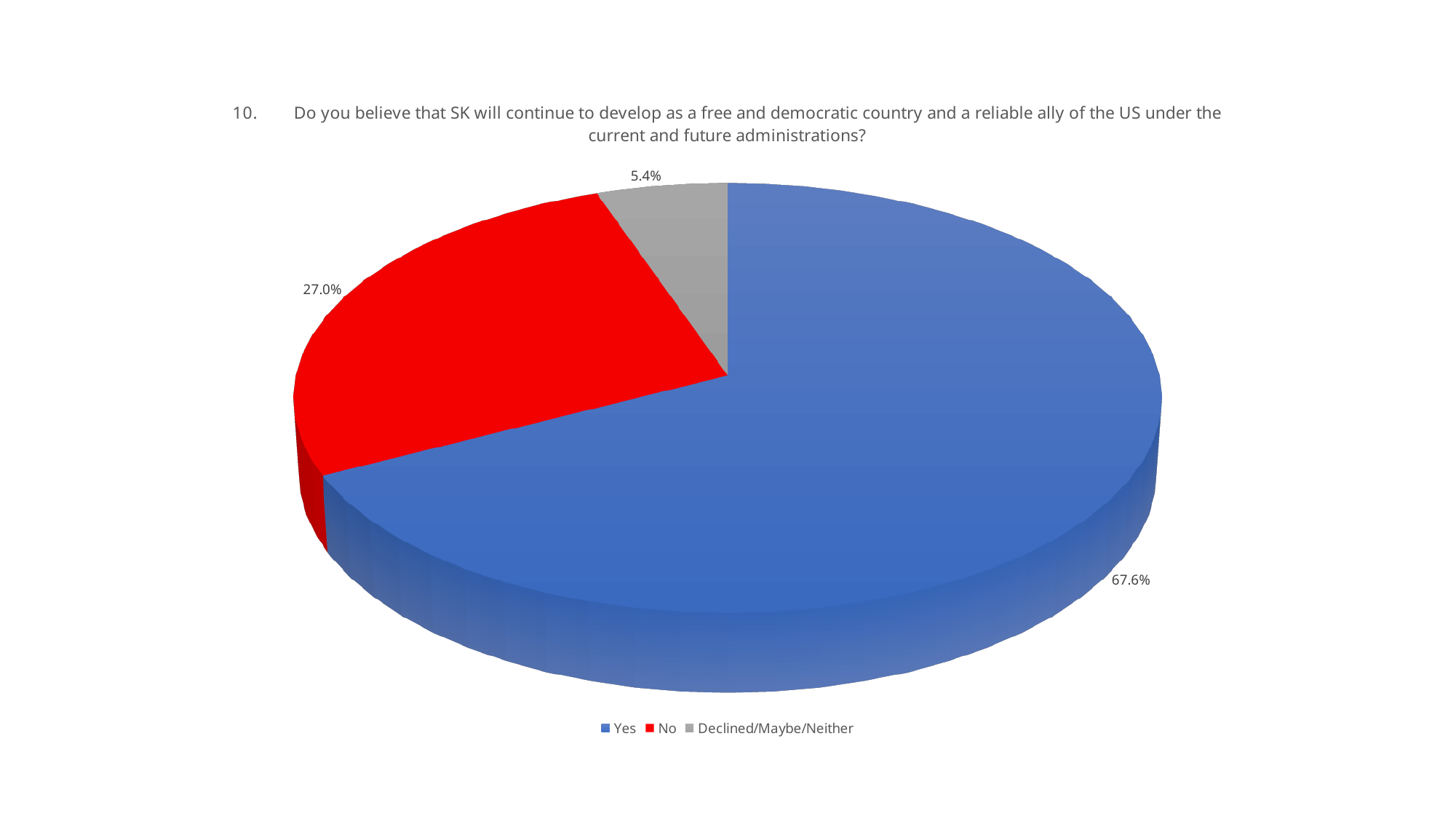
Which response category has the largest share of the pie? Yes What kind of chart is shown on the slide? Pie chart What is the third entry listed in the legend? Declined/Maybe/Neither What colour is the slice representing No? Red Which is larger, the share for No or the share for Declined/Maybe/Neither? No Which response category has the smallest share of the pie? Declined/Maybe/Neither What percentage of respondents answered Yes? 67.6% How many categories does the pie chart show? 3 What is the difference in percentage points between the Yes and No shares? 40.6 What percentage of respondents are in the Declined/Maybe/Neither category? 5.4% What percentage of respondents answered No? 27.0% What is the combined share of the No and Declined/Maybe/Neither slices? 32.4%